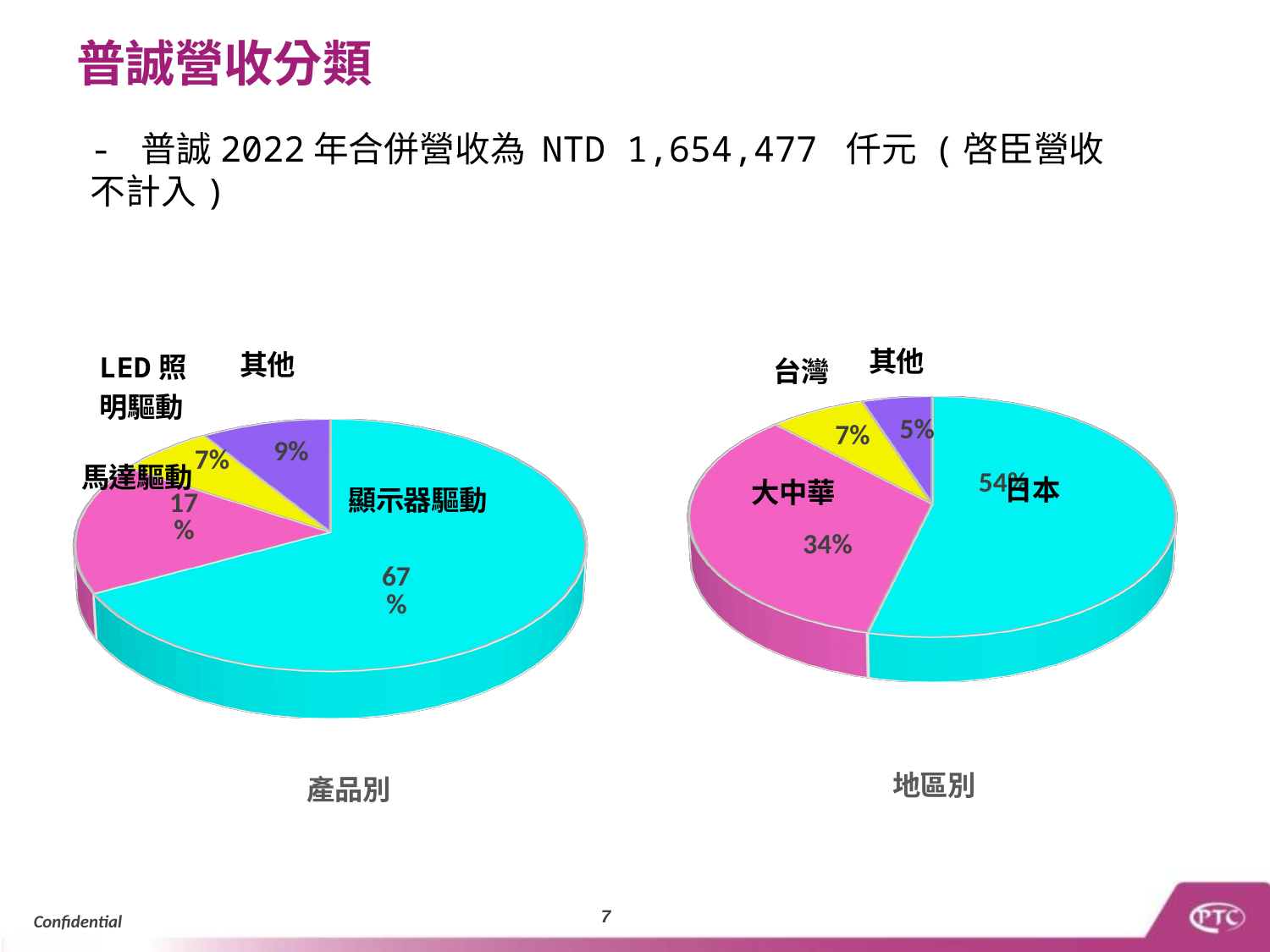
How many slices does the 地區別 chart have? 4 In the 產品別 chart, what share of revenue is 馬達驅動? 17% In the 產品別 chart, what share of revenue is LED 照明驅動? 7% In the 產品別 chart, what is the difference between the shares of 顯示器驅動 and 馬達驅動? 50% In the 產品別 chart, what share of revenue is 顯示器驅動? 67% In the 產品別 chart, which category has the smallest share? LED 照明驅動 In the 產品別 chart, which category has the largest share? 顯示器驅動 In the 地區別 chart, which region has the smallest share? 其他 In the 地區別 chart, what share of revenue is 台灣? 7% What kind of chart is the 產品別 chart? Pie chart In the 地區別 chart, what share of revenue is 大中華? 34% In the 地區別 chart, which is larger, the share of 大中華 or the share of 台灣? 大中華